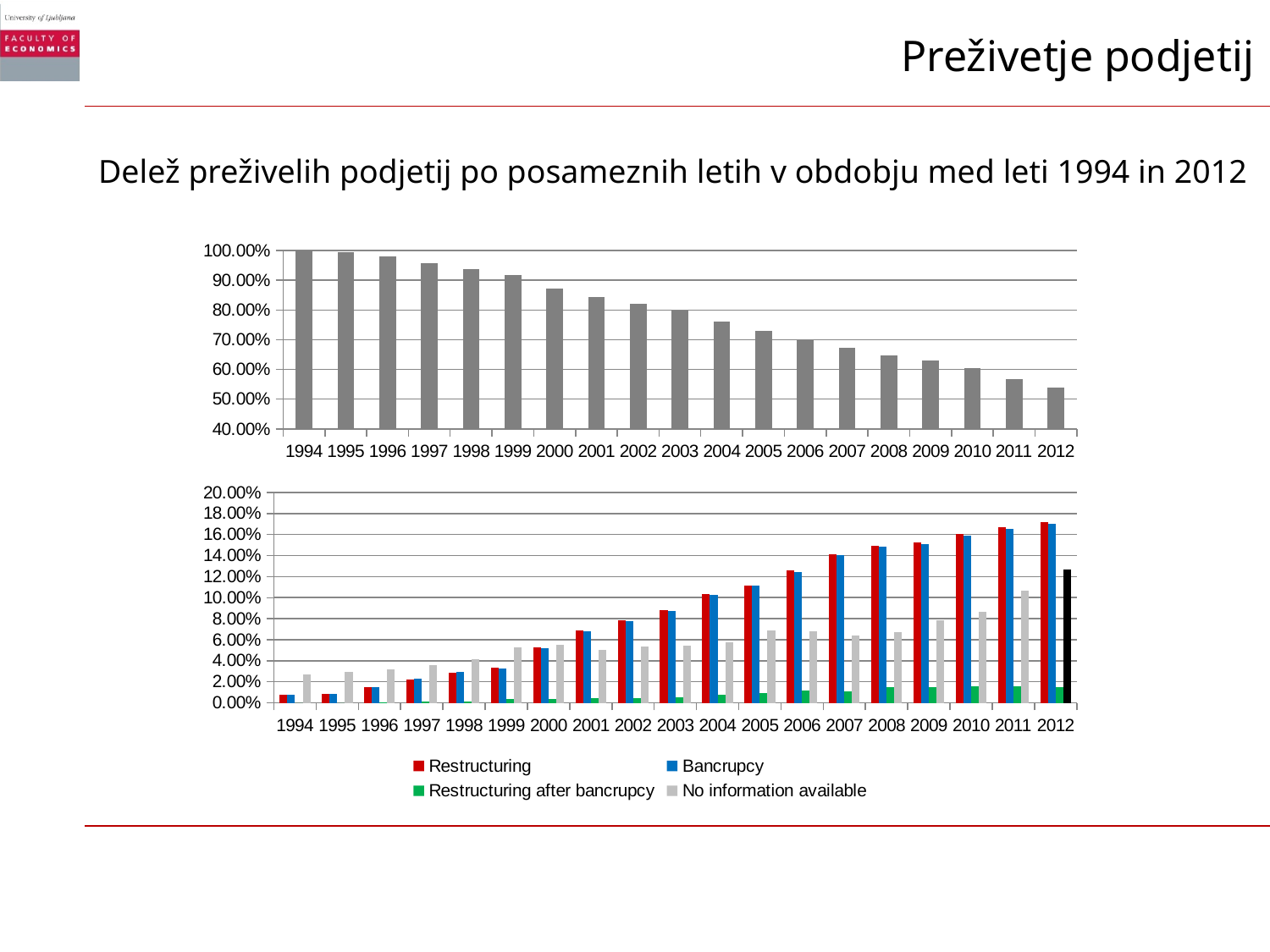
How many series does the legend of the bottom chart list? 4 In the bottom chart, which series is shown in red? Restructuring What kind of chart is the top chart on the slide? bar chart In the bottom chart, is the Restructuring value for 2012 greater or less than 16.00%? greater In the top chart, which year has the lowest value? 2012 In the bottom chart, which year has the highest Restructuring value? 2012 In the top chart, do the values rise or fall from 1994 to 2012? fall In the top chart, is the value for 2004 greater or less than 70.00%? greater In the top chart, is the value for 2008 greater or less than 70.00%? less In the top chart, which year has the highest value? 1994 In the top chart, how many years are shown on the x axis? 19